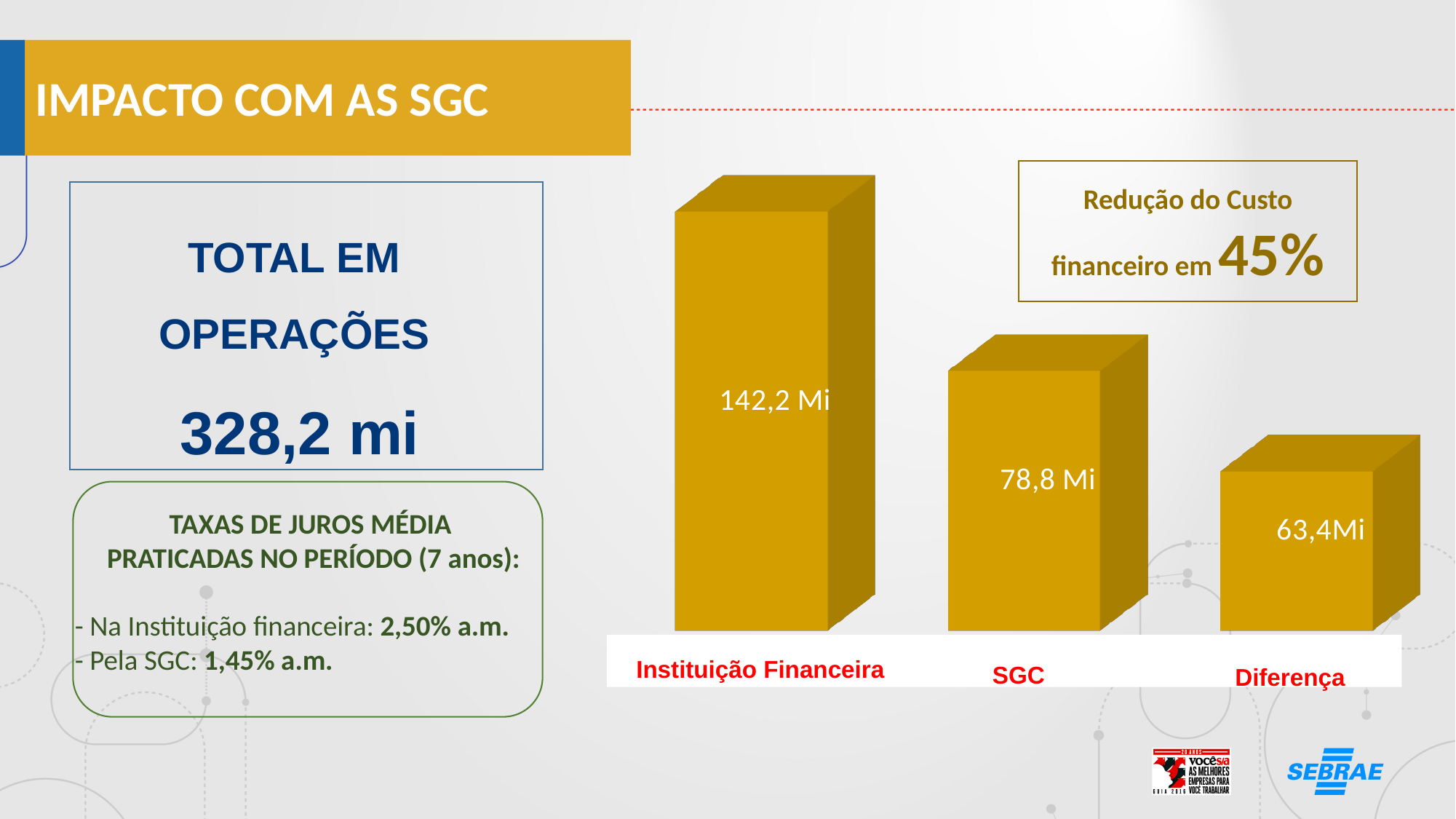
Do the values rise or fall from left to right across the categories? Fall What value is shown for Instituição Financeira? 142,2 Mi What value is shown for Diferença? 63,4Mi Which category has the lowest value? Diferença What is the difference between the values for Instituição Financeira and SGC? 63,4 Mi How many categories are shown in the chart? 3 Which is larger, the value for Instituição Financeira or the value for SGC? Instituição Financeira What value is shown for SGC? 78,8 Mi What is the difference between the values for SGC and Diferença? 15,4 Mi Which category has the highest value? Instituição Financeira Which is larger, the value for SGC or the value for Diferença? SGC What kind of chart is shown on the slide? Bar chart